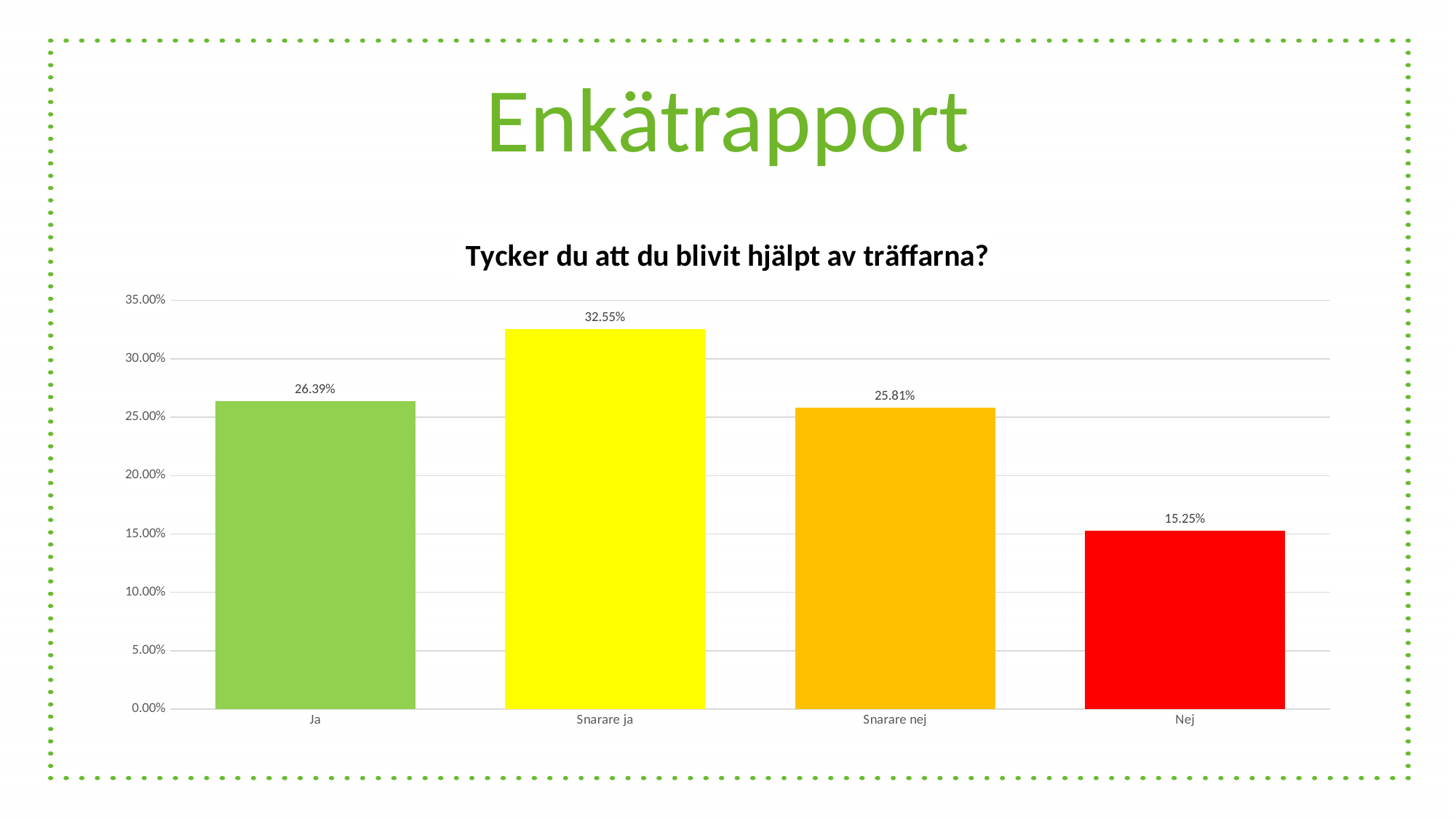
What is the value for Ja? 26.39% Which is larger, the value for Ja or the value for Nej? Ja What is the value for Snarare nej? 25.81% What is the value for Snarare ja? 32.55% What is the value for Nej? 15.25% Is the value for Snarare nej greater or less than 20.00%? greater What kind of chart is shown on the slide? Bar chart What is the difference between the values for Snarare ja and Nej? 17.30% How many categories are shown in the chart? 4 What is the title of the chart? Tycker du att du blivit hjälpt av träffarna? Which category has the lowest value? Nej Which category has the highest value? Snarare ja